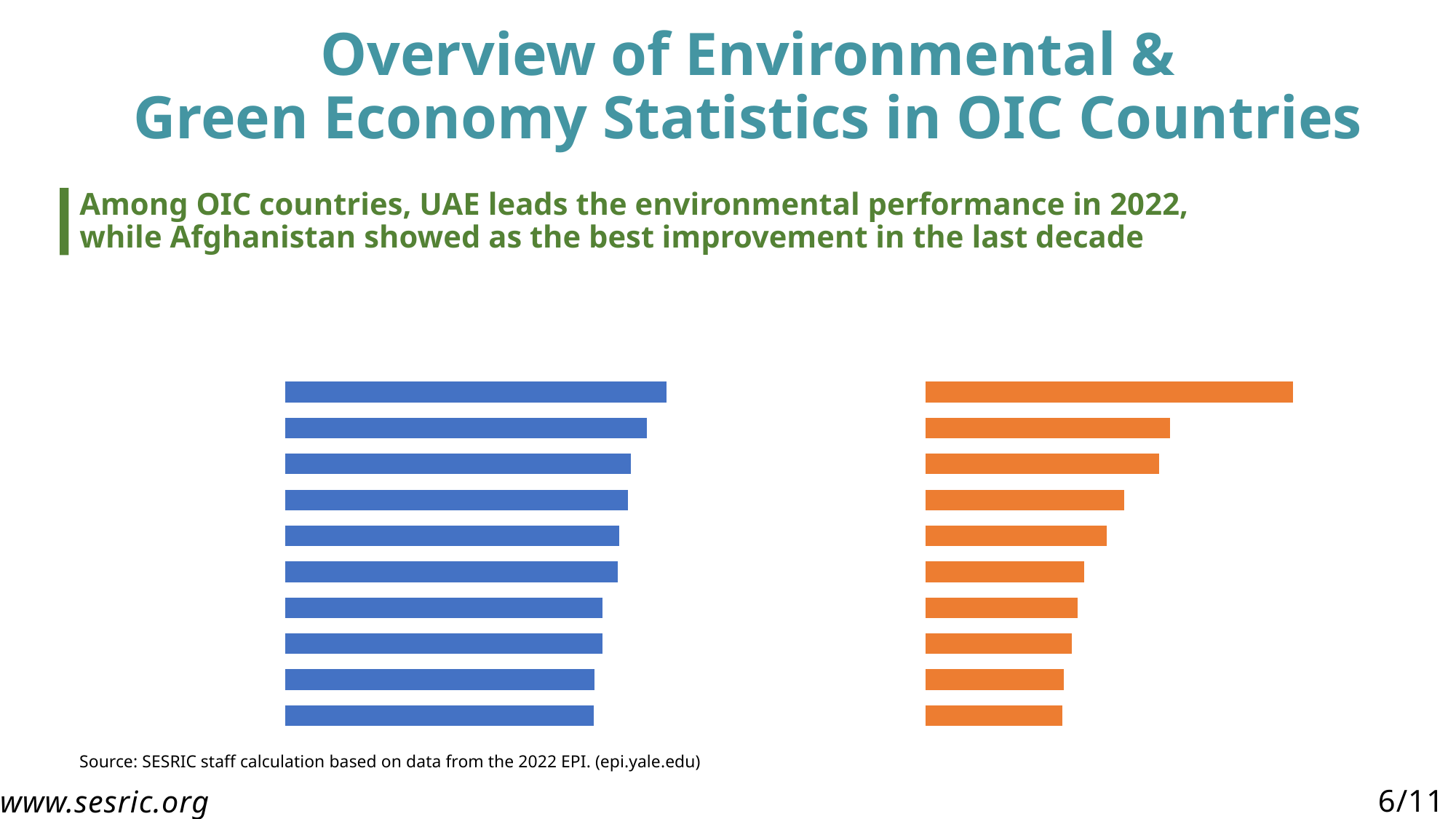
What colour are the bars in the chart on the right side of the slide? orange In the chart on the right side of the slide, do the bars get longer or shorter going from top to bottom? shorter How many bars does the chart on the left side of the slide have? 10 In the chart on the right side of the slide, is the top bar longer or shorter than the second bar from the top? longer In the chart on the left side of the slide, is the bottom bar longer or shorter than the top bar? shorter What colour are the bars in the chart on the left side of the slide? blue How many bars does the chart on the right side of the slide have? 10 What kind of chart is the chart on the right side of the slide? bar chart In the chart on the left side of the slide, do the bars get longer or shorter going from top to bottom? shorter What kind of chart is the chart on the left side of the slide? bar chart